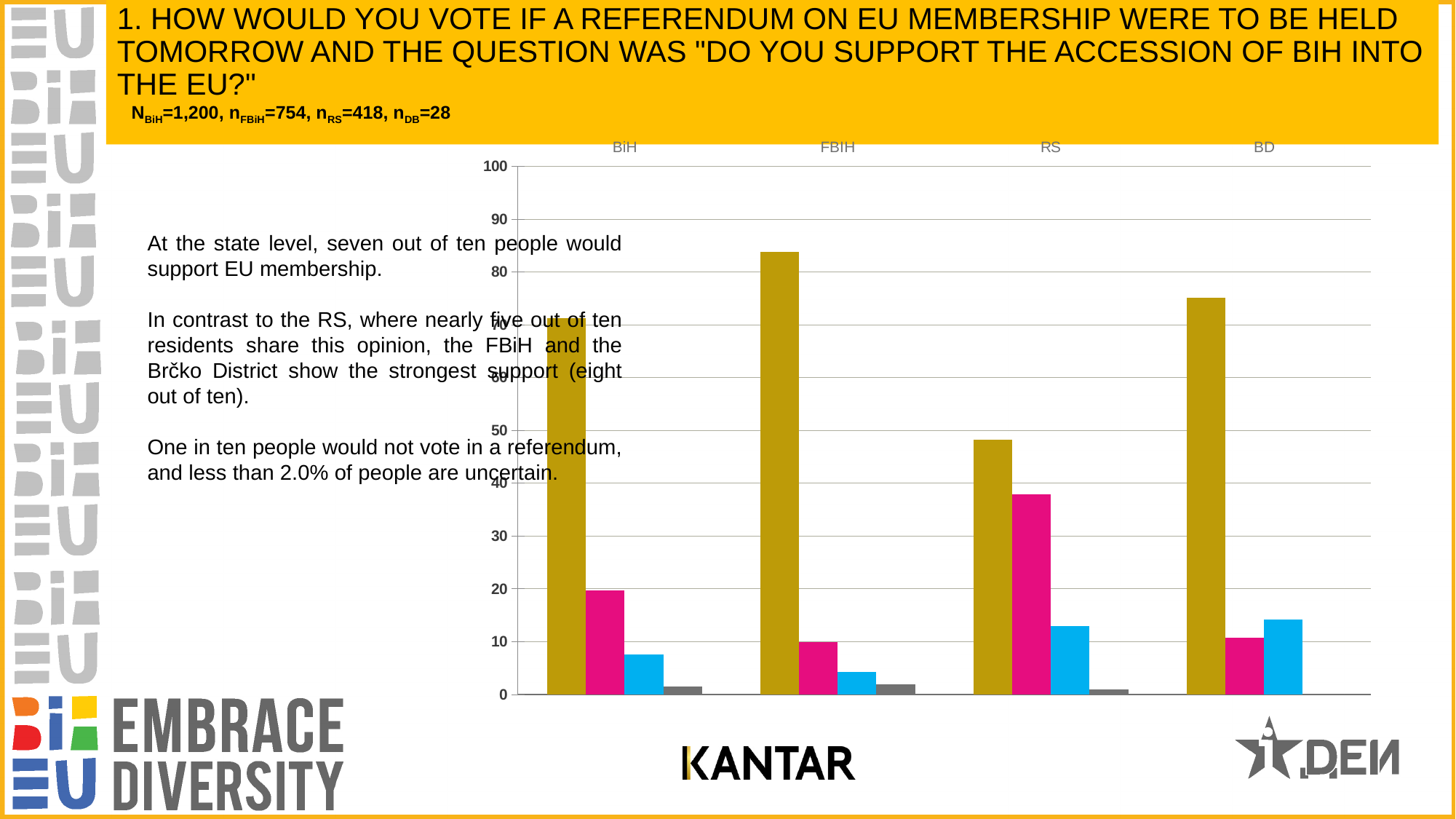
Is the value of the gold (first) bar for FBIH greater or less than 80? greater Which is larger: the gold (first) bar for FBIH or the gold (first) bar for BD? FBIH Which category has the tallest magenta (second) bar? RS Which category has the tallest gold (first) bar? FBIH Which category has the shortest gold (first) bar? RS What kind of chart is shown on the slide? bar chart Which is larger: the magenta (second) bar for RS or the magenta (second) bar for BiH? RS How many categories are shown along the x axis of the chart? 4 How many bars are plotted for each category in the chart? 4 Is the value of the blue (third) bar for FBIH greater or less than 10? less Is the value of the gold (first) bar for RS greater or less than 50? less